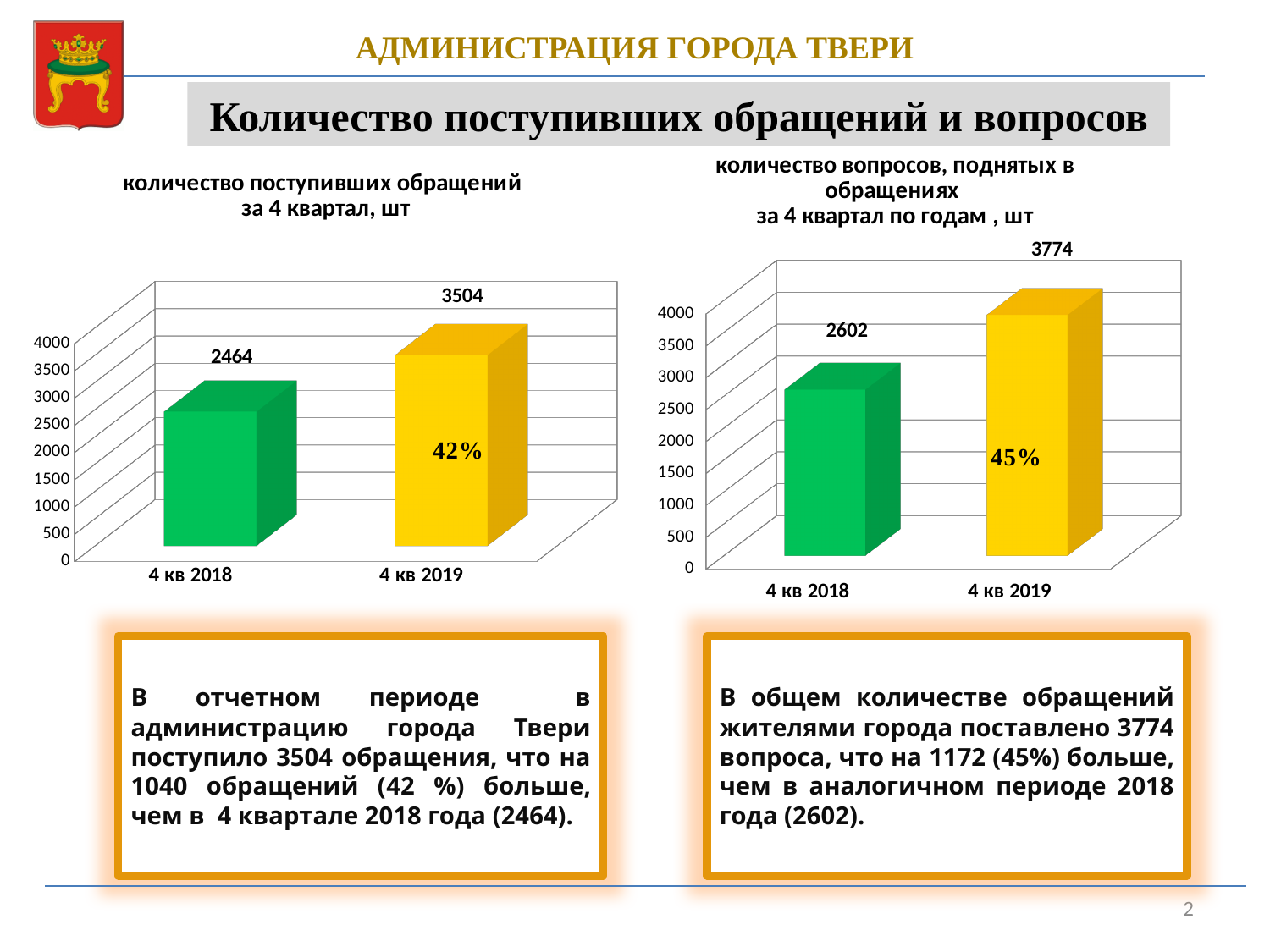
In the left chart, which category has the highest value? 4 кв 2019 In the right chart (количество вопросов, поднятых в обращениях), what is the value for 4 кв 2018? 2602 In the left chart, what percentage label is printed on the 4 кв 2019 bar? 42% In the right chart, what is the difference between the values for 4 кв 2019 and 4 кв 2018? 1172 In the right chart, which category has the lowest value? 4 кв 2018 In the right chart (количество вопросов, поднятых в обращениях), what is the value for 4 кв 2019? 3774 In the left chart, what is the difference between the values for 4 кв 2019 and 4 кв 2018? 1040 In the left chart (количество поступивших обращений за 4 квартал, шт), what is the value for 4 кв 2019? 3504 How many categories are shown in the left chart? 2 What type of chart is the right chart? Bar chart In the right chart, which is larger: the value for 4 кв 2018 or 4 кв 2019? 4 кв 2019 In the left chart (количество поступивших обращений за 4 квартал, шт), what is the value for 4 кв 2018? 2464